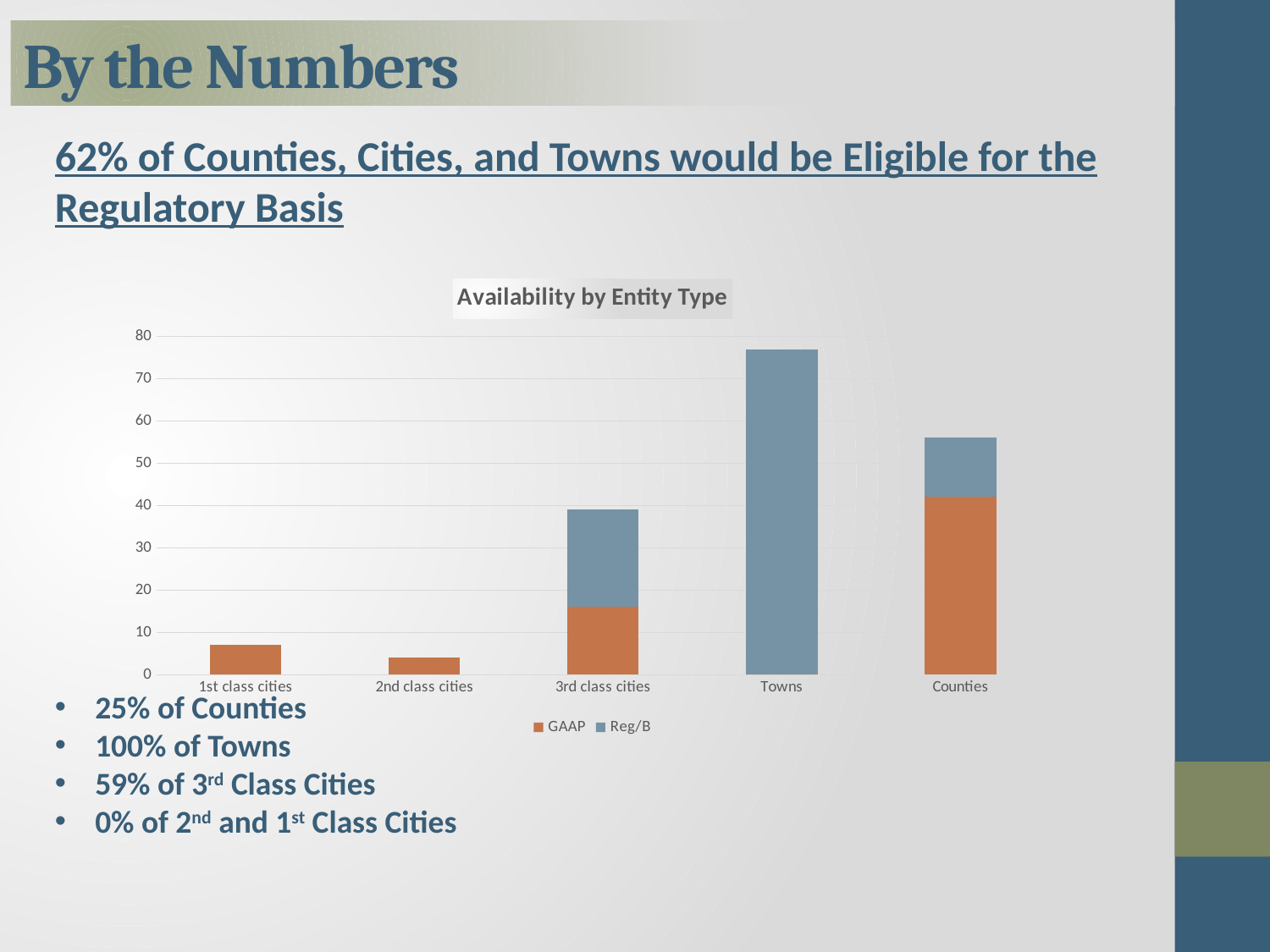
How many categories are shown on the x axis of the chart? 5 Which category has the tallest bar in the chart? Towns Is the total value for Counties greater or less than 50? greater Which has the larger total bar, Counties or 3rd class cities? Counties What is the title of the chart? Availability by Entity Type What kind of chart is shown on the slide? bar chart Is the total value for 3rd class cities greater or less than 30? greater Is the total value for Towns greater or less than 70? greater How many series does the chart's legend list? 2 Which two series are listed in the chart's legend? GAAP and Reg/B Which category has the shortest bar in the chart? 2nd class cities